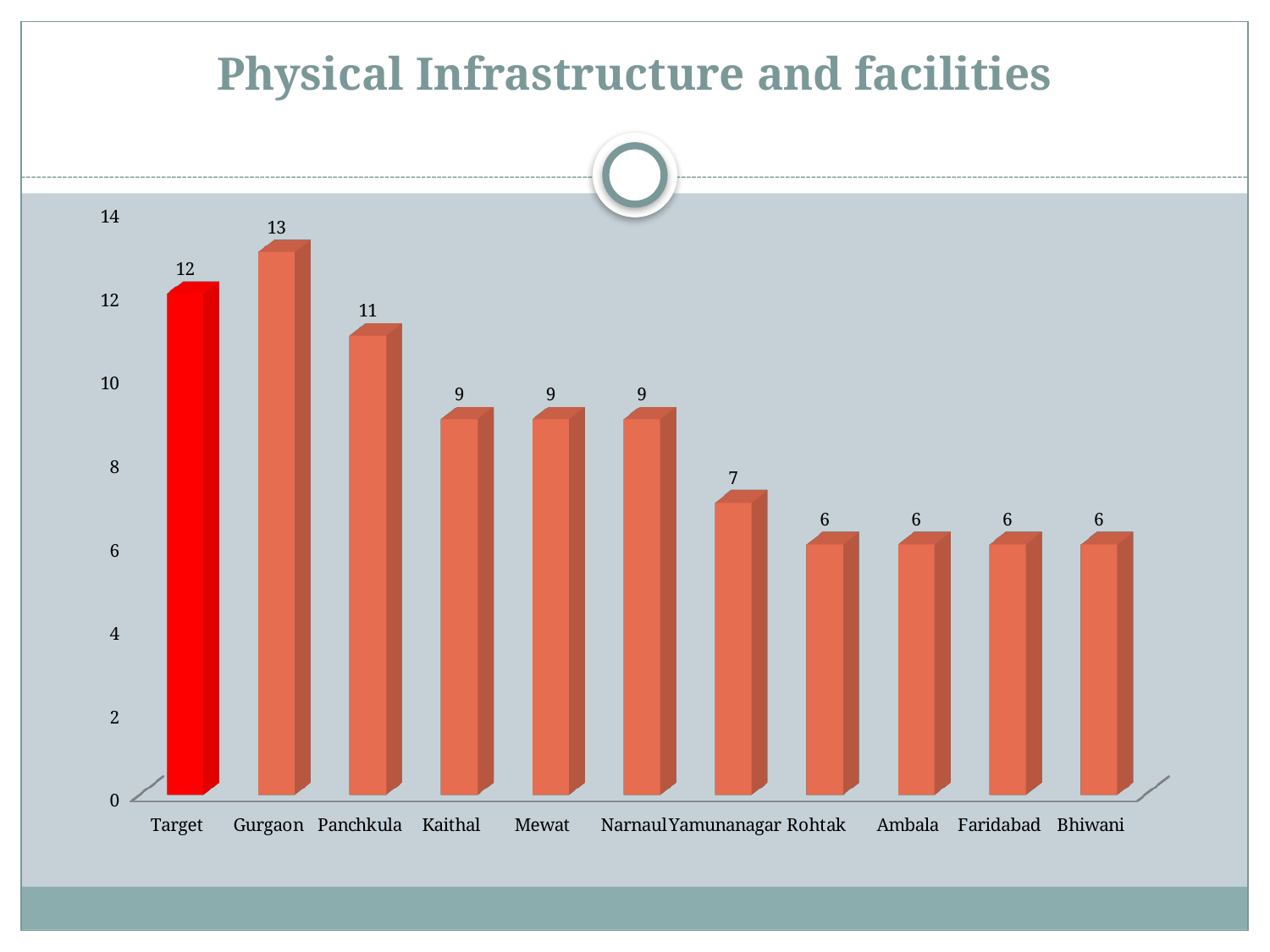
How many categories are shown on the x axis? 11 What kind of chart is shown on the slide? bar chart Which category has the highest value? Gurgaon Which is larger, the value for Panchkula or the value for Kaithal? Panchkula What is the difference between the values for Gurgaon and Panchkula? 2 Is the value for Mewat greater or less than 8? greater What is the value for Target? 12 Which bar is coloured differently (red) from the others? Target What is the difference between the values for Target and Rohtak? 6 What is the value for Yamunanagar? 7 What is the value for Gurgaon? 13 Do the values generally rise or fall from Gurgaon to Bhiwani along the x axis? fall